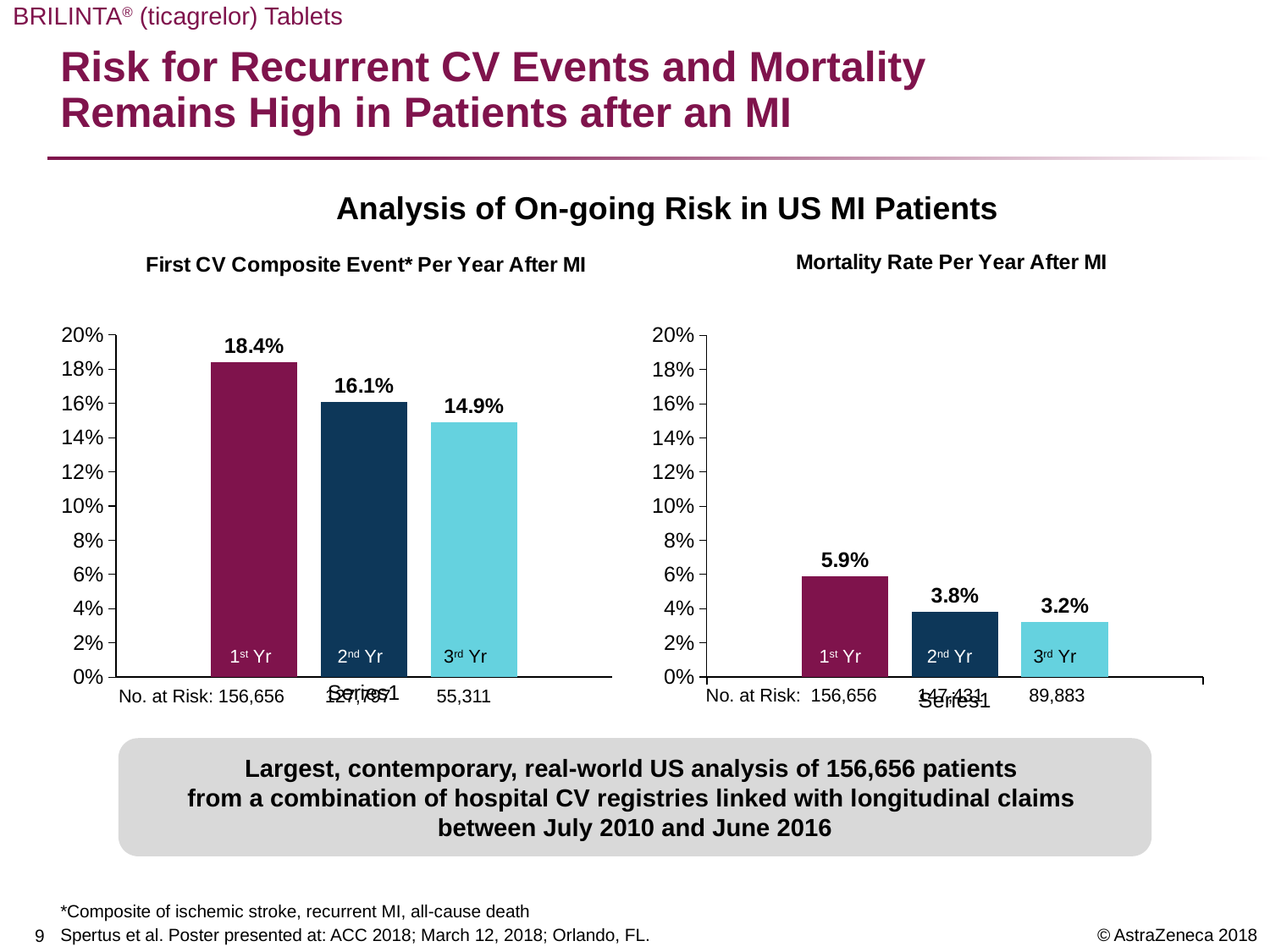
In the 'Mortality Rate Per Year After MI' chart, which year has the lowest value? 3rd Yr In the 'First CV Composite Event* Per Year After MI' chart, what is the value for the 3rd Yr? 14.9% In the 'Mortality Rate Per Year After MI' chart, what is the value for the 1st Yr? 5.9% In the 'First CV Composite Event* Per Year After MI' chart, how many bars are plotted? 3 In the 'First CV Composite Event* Per Year After MI' chart, which year has the highest value? 1st Yr In the 'Mortality Rate Per Year After MI' chart, what is the difference between the 1st Yr and 3rd Yr values? 2.7% In the 'First CV Composite Event* Per Year After MI' chart, what is the difference between the 1st Yr and 2nd Yr values? 2.3% In the 'First CV Composite Event* Per Year After MI' chart, do the values rise or fall from the 1st Yr to the 3rd Yr? Fall In the 'Mortality Rate Per Year After MI' chart, is the value for the 1st Yr greater or less than 4%? greater In the 'First CV Composite Event* Per Year After MI' chart, what is the value for the 1st Yr? 18.4% What type of chart is the 'Mortality Rate Per Year After MI' chart? Bar chart In the 'Mortality Rate Per Year After MI' chart, what is the value for the 2nd Yr? 3.8%